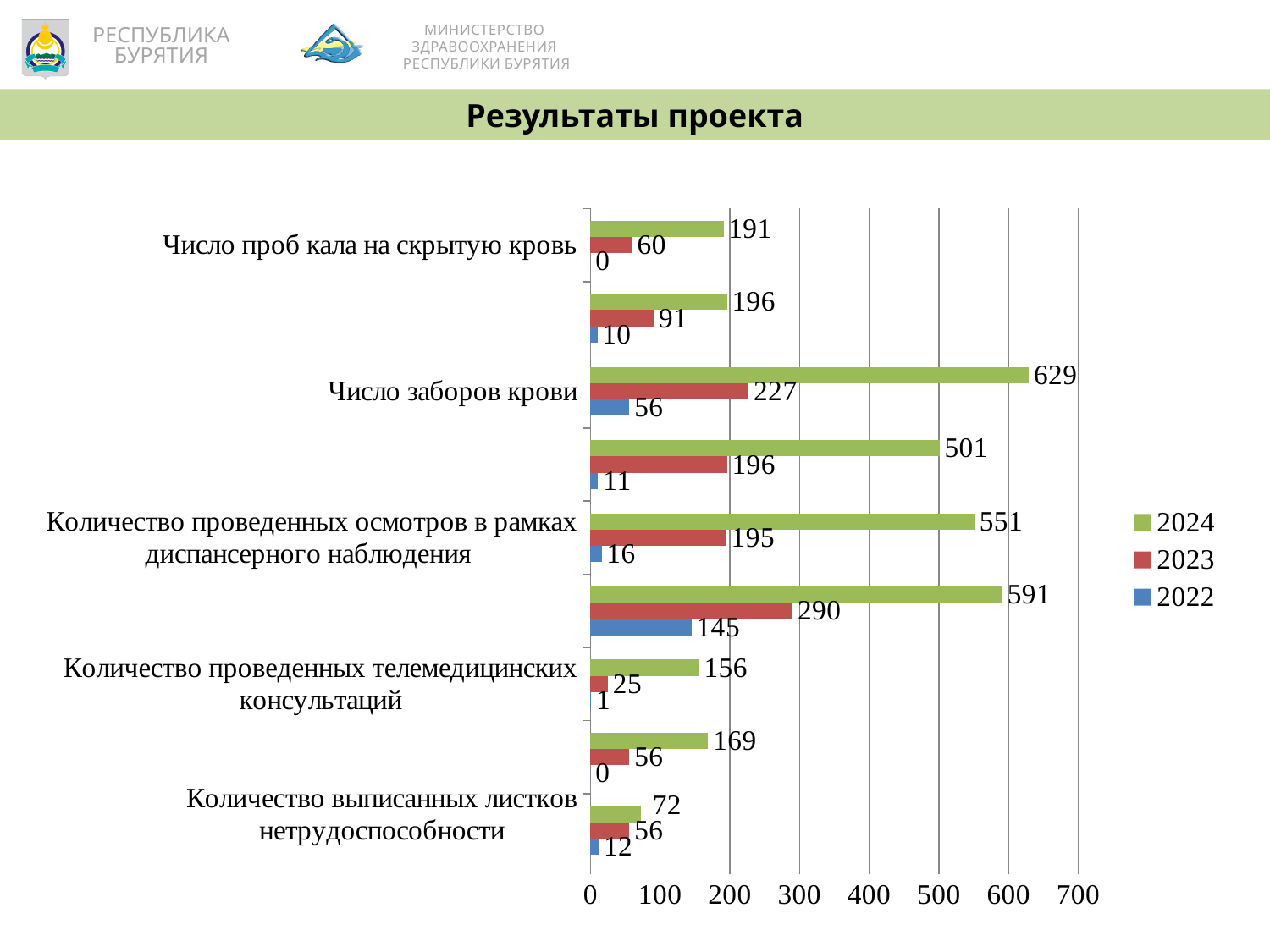
What is the difference between the 2024 and 2023 values for Число заборов крови? 402 What is the 2022 value for Число заборов крови? 56 What is the 2022 value for Количество выписанных листков нетрудоспособности? 12 What is the 2023 value for Число проб кала на скрытую кровь? 60 How many series does the legend list? 3 What is the 2024 value for Количество проведенных телемедицинских консультаций? 156 What is the difference between the 2024 and 2022 values for Количество выписанных листков нетрудоспособности? 60 Does the value for Число заборов крови rise or fall from 2022 to 2024? Rise What kind of chart is shown on the slide? Bar chart Which year has the highest value for Число заборов крови? 2024 What is the 2024 value for Число заборов крови? 629 Which is larger: the 2024 value for Число заборов крови or the 2024 value for Количество проведенных осмотров в рамках диспансерного наблюдения? Число заборов крови